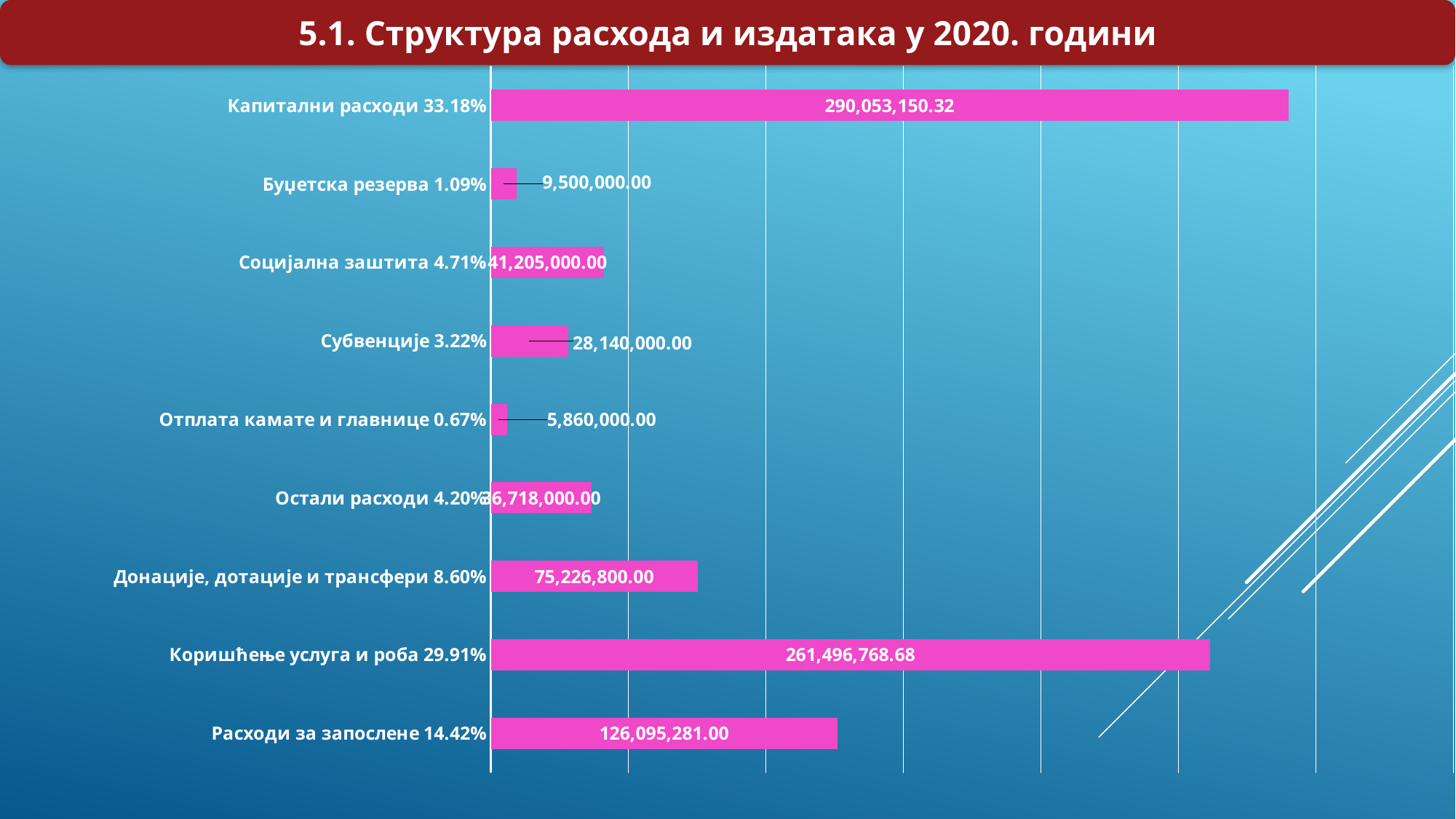
What is the value for Буџетска резерва? 9,500,000.00 What type of chart is shown on the slide? Bar chart What is the value for Капитални расходи? 290,053,150.32 What is the difference between the values for Капитални расходи and Коришћење услуга и роба? 28,556,381.64 What is the value for Донације, дотације и трансфери? 75,226,800.00 Which category has the lowest value? Отплата камате и главнице What is the difference between the values for Социјална заштита and Субвенције? 13,065,000.00 What is the value for Расходи за запослене? 126,095,281.00 Which is larger, the value for Расходи за запослене or the value for Донације, дотације и трансфери? Расходи за запослене Which category has the highest value? Капитални расходи What is the value for Коришћење услуга и роба? 261,496,768.68 How many categories are shown in the chart? 9